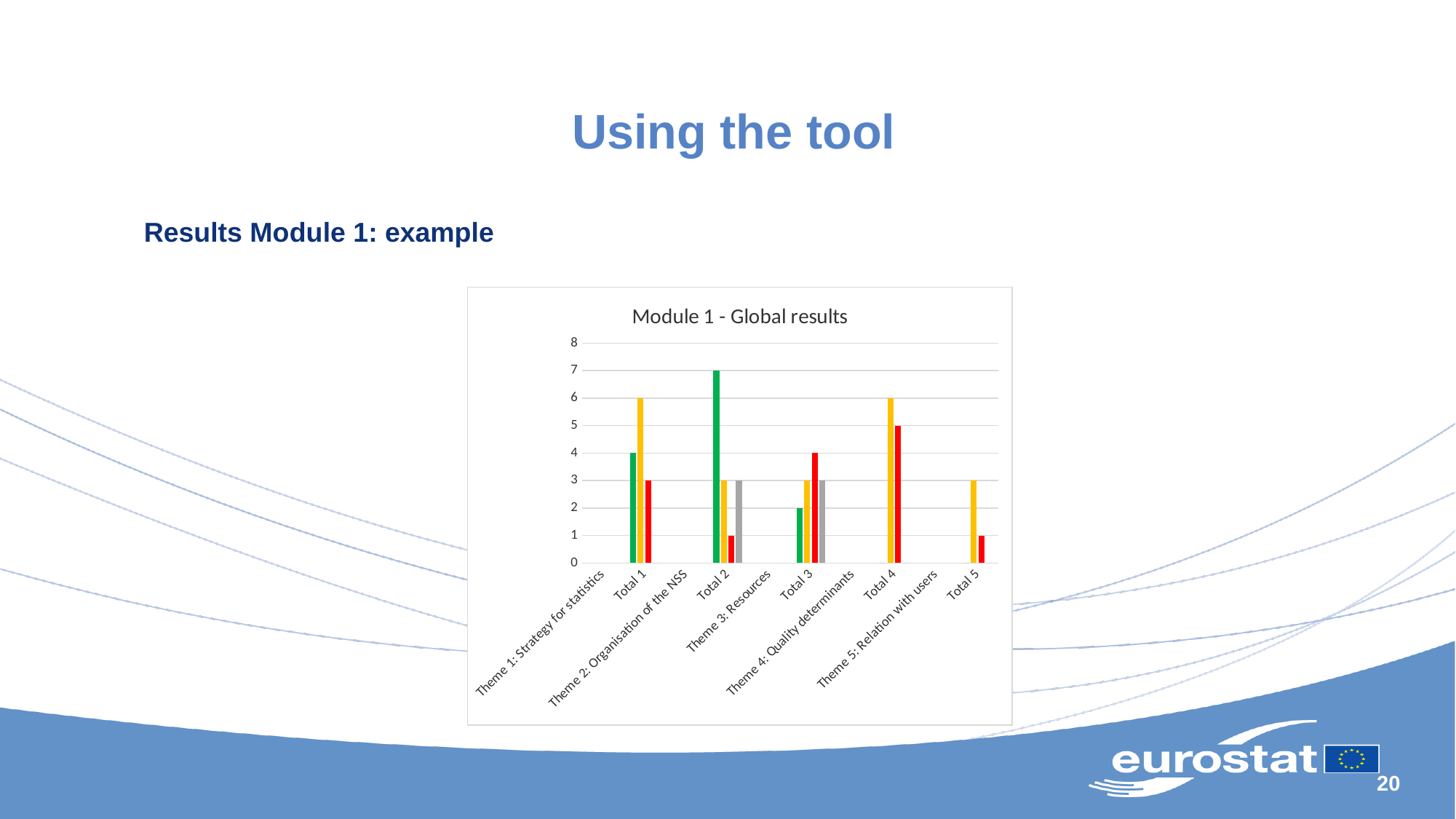
What is the difference between the green bar for Total 2 and the green bar for Total 3? 5 Which category has the tallest bar in the chart? Total 2 What is the value of the red bar for Total 4? 5 What is the title of the chart? Module 1 - Global results What is the value of the green bar for Total 2? 7 Is the red bar for Total 5 greater or less than 2? less Is the green bar for Total 2 greater or less than 6? greater How many categories are labelled on the x axis of the chart? 10 Which is larger, the yellow bar for Total 4 or the yellow bar for Total 5? Total 4 What is the highest value shown on the y axis of the chart? 8 What is the value of the yellow bar for Total 1? 6 What kind of chart is shown on the slide? bar chart